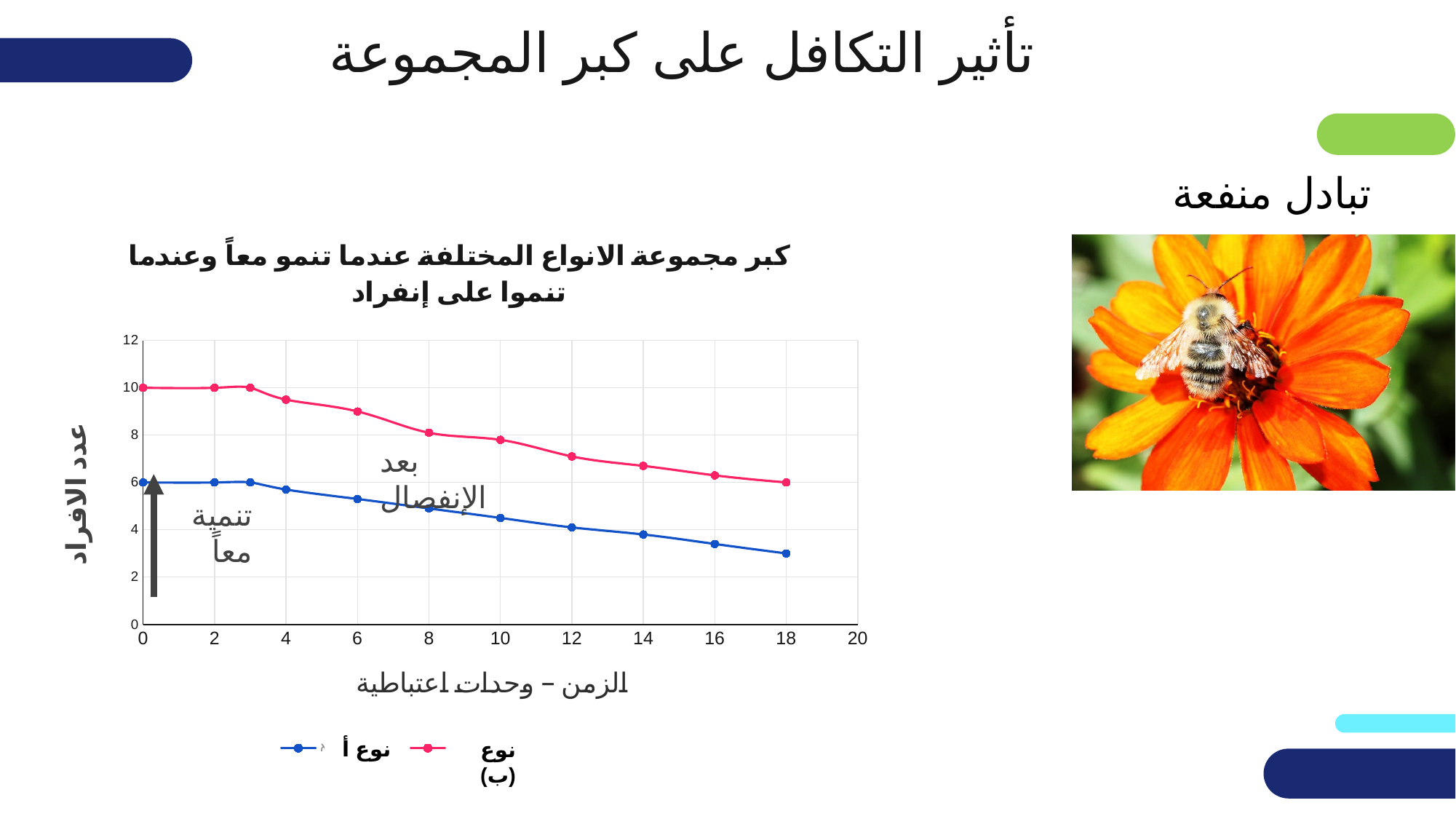
Is the value for نوع (ب) at time 6 greater or less than 8? greater How many series does the chart legend list? 2 What is the title of the x axis? الزمن – وحدات اعتباطية Which series has the highest value on the chart? نوع (ب) How many data points are plotted for the series نوع (ب)? 11 What kind of chart is shown on the slide? line chart What is the value of نوع أ at time 0? 6 Is the value for نوع أ at time 18 greater or less than 4? less What is the difference between نوع (ب) and نوع أ at time 0? 4 Do the values of نوع أ rise or fall as time increases along the x axis? fall What is the value of نوع (ب) at time 0? 10 Which series has the higher value at time 10, نوع أ or نوع (ب)? نوع (ب)